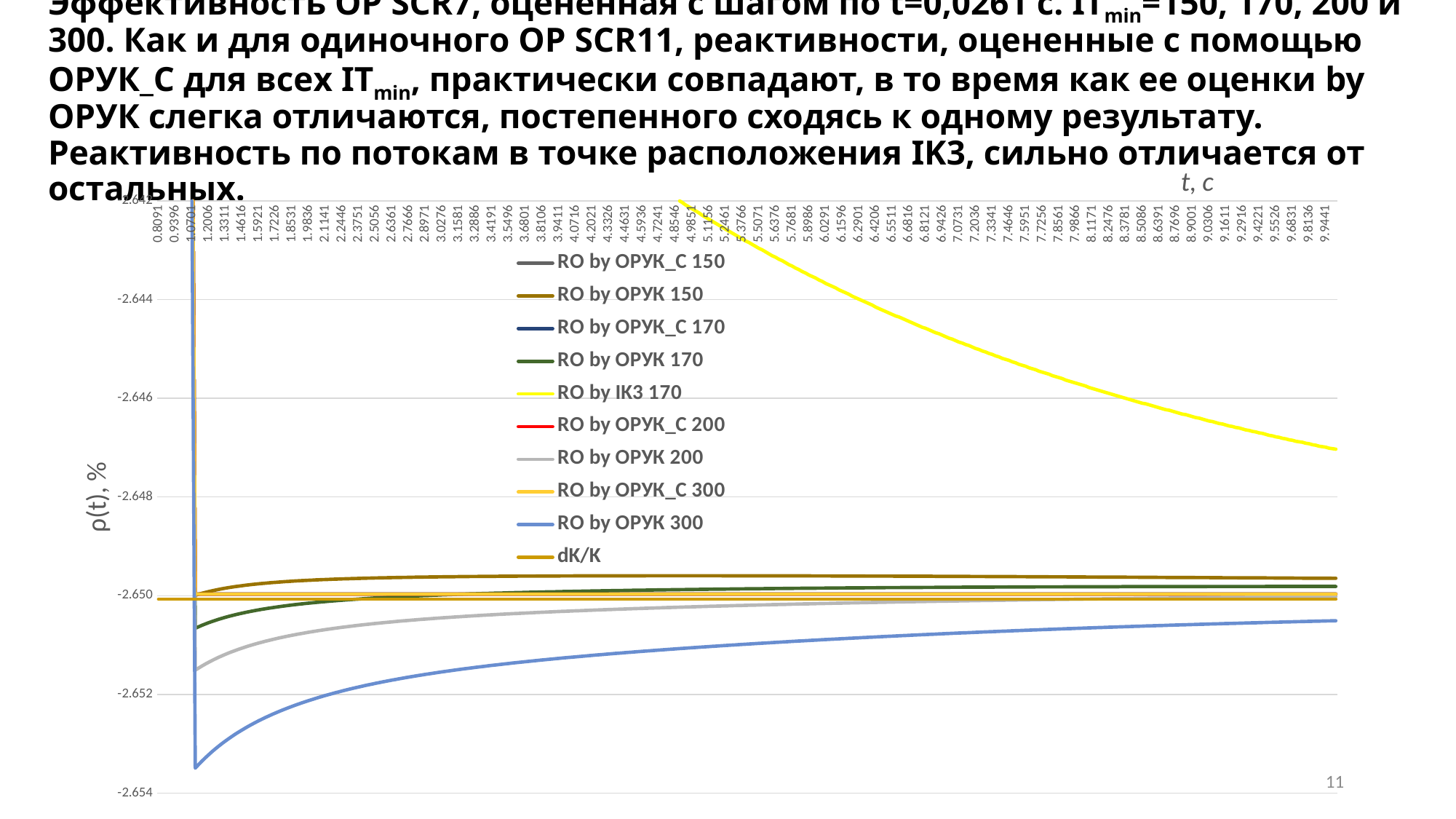
How many series does the legend list? 10 At the right end of the chart, which is lower: RO by ОРУК 300 or RO by ОРУК 150? RO by ОРУК 300 Is the lowest value of the RO by ОРУК 300 line greater or less than -2.652? less Does the RO by ОРУК 300 line rise or fall as t increases after its initial drop? rise Is the value of RO by ОРУК 150 at the right end of the chart greater or less than -2.650? greater Is the value of RO by IK3 170 at the right end of the chart greater or less than -2.648? greater Which series reaches the highest values on the chart? RO by IK3 170 Which series is drawn in yellow? RO by IK3 170 Does the RO by IK3 170 line rise or fall as t increases? fall At the right end of the chart, which is higher: RO by IK3 170 or RO by ОРУК 300? RO by IK3 170 What kind of chart is shown on the slide? line chart What is the label of the vertical axis? ρ(t), %